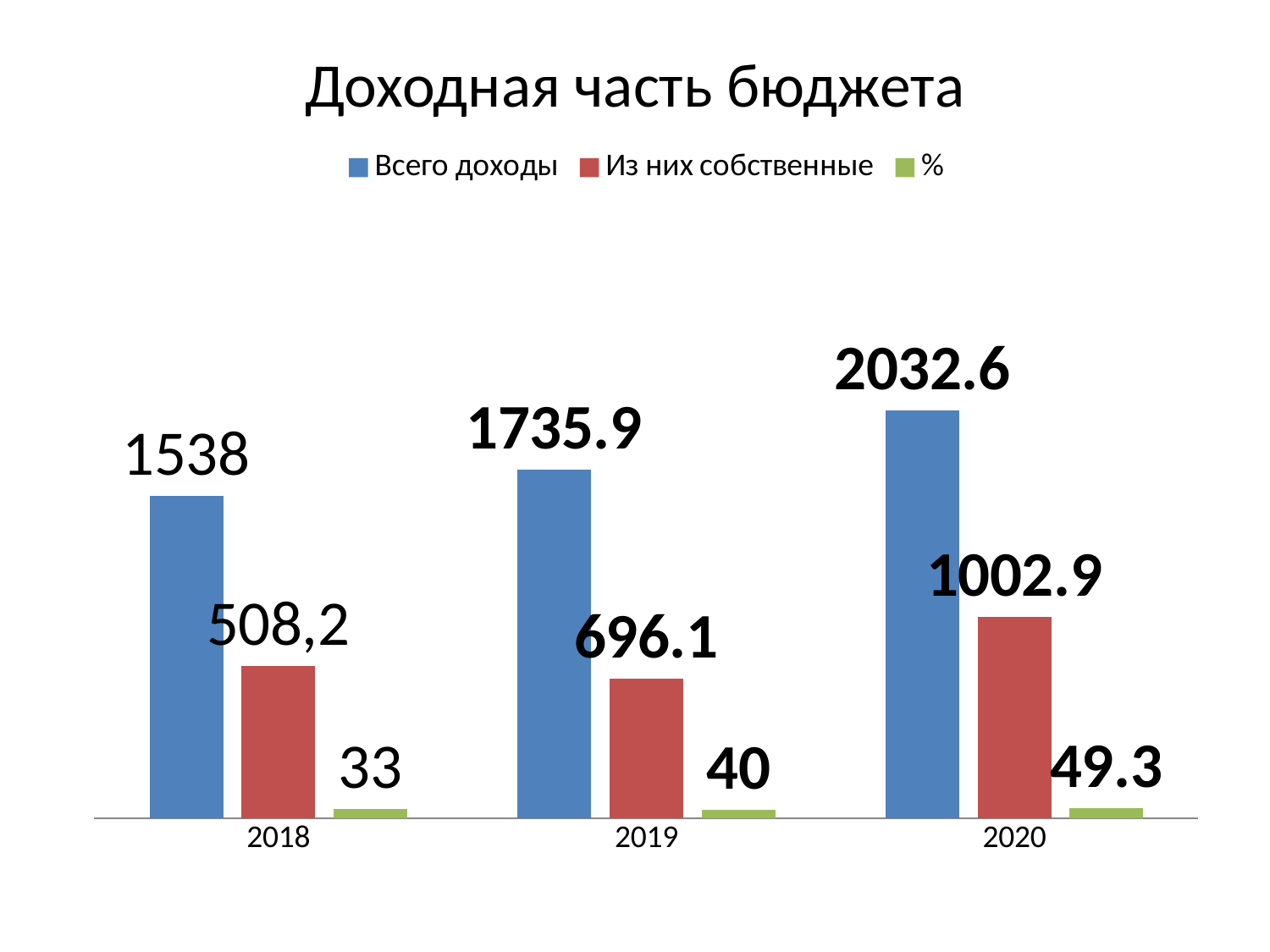
Which is larger: Всего доходы in 2019 or Из них собственные in 2020? Всего доходы in 2019 What is the value of Из них собственные for 2020? 1002.9 In which year is Всего доходы the highest? 2020 What is the value of the % series for 2020? 49.3 Does Всего доходы rise or fall from 2018 to 2020? rise How many series does the legend list? 3 What is the value of Всего доходы for 2019? 1735.9 What is the difference between Всего доходы in 2020 and in 2018? 494.6 How many years are shown on the x axis? 3 What is the difference between Из них собственные in 2020 and in 2019? 306.8 What is the value of Из них собственные for 2018? 508,2 In which year is the % series the lowest? 2018